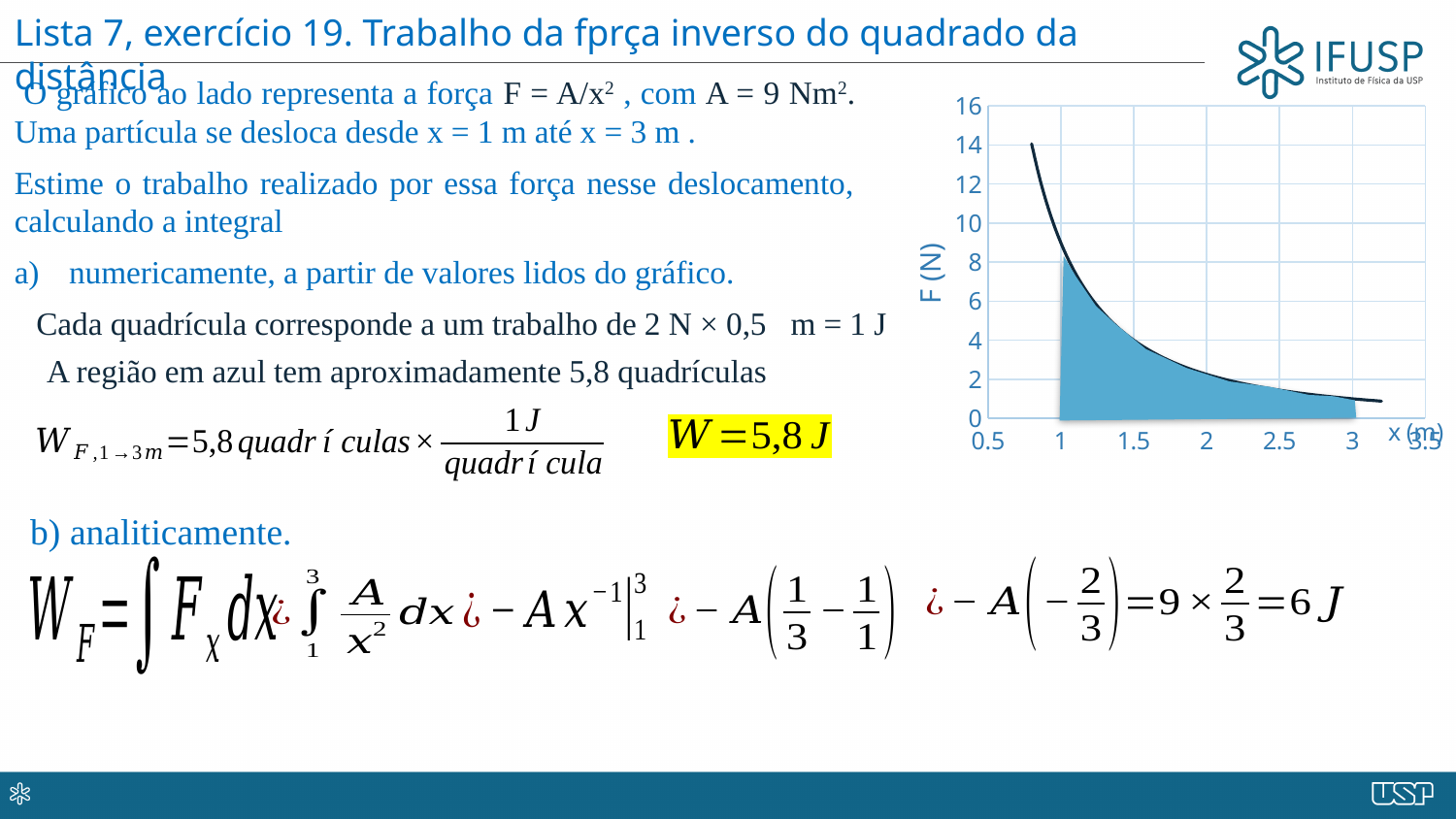
Is the value of F at x = 2.5 m greater or less than 2 N? less What is the label of the vertical axis of the chart? F (N) Is the value of F at x = 1 m greater or less than 12 N? less Which is larger, the force at x = 1 m or the force at x = 3 m? x = 1 m Does the force F rise or fall as x increases along the x axis? falls Is the value of F at x = 3 m greater or less than 2 N? less Which is larger, the force at x = 1.5 m or the force at x = 2.5 m? x = 1.5 m What is the highest value shown on the vertical axis of the chart? 16 What kind of chart is shown on the slide? line chart (with shaded area)